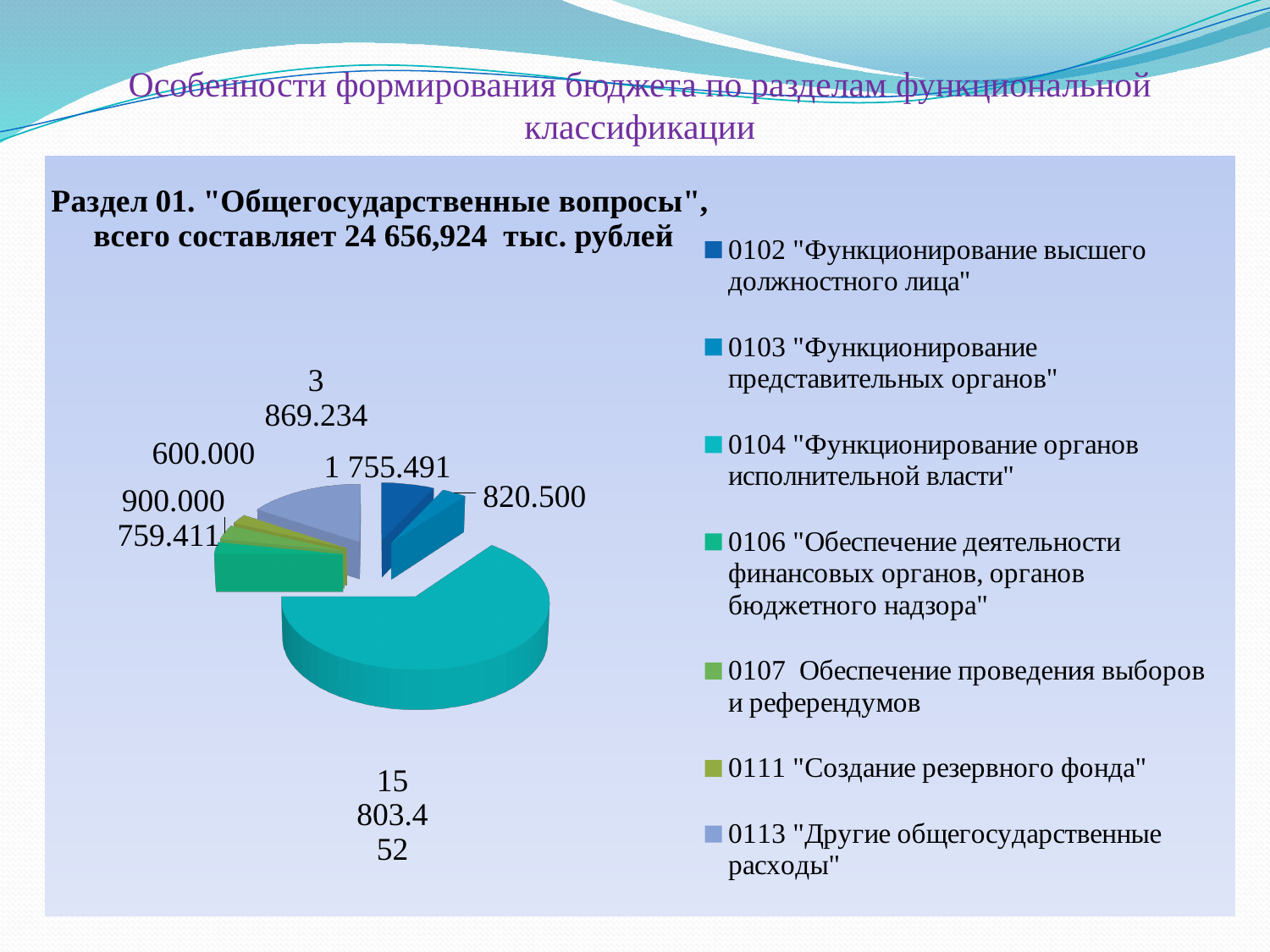
Which is larger, the value for 0102 "Функционирование высшего должностного лица" or for 0103 "Функционирование представительных органов"? 0102 "Функционирование высшего должностного лица" Which category has the largest slice of the pie? 0104 "Функционирование органов исполнительной власти" According to the chart title, what is the total for Раздел 01 "Общегосударственные вопросы"? 24 656,924 тыс. рублей Which category has the smallest slice of the pie? 0111 "Создание резервного фонда" How many slices does the pie chart have? 7 What is the value shown for 0103 "Функционирование представительных органов"? 820.500 What is the value shown for 0102 "Функционирование высшего должностного лица"? 1 755.491 What is the difference between the values for 0107 (Обеспечение проведения выборов и референдумов) and 0111 ("Создание резервного фонда")? 300.000 What is the value shown for 0113 "Другие общегосударственные расходы"? 3 869.234 How many entries does the legend of the pie chart list? 7 What kind of chart is shown on the slide? pie chart What is the value shown for 0104 "Функционирование органов исполнительной власти"? 15 803.452